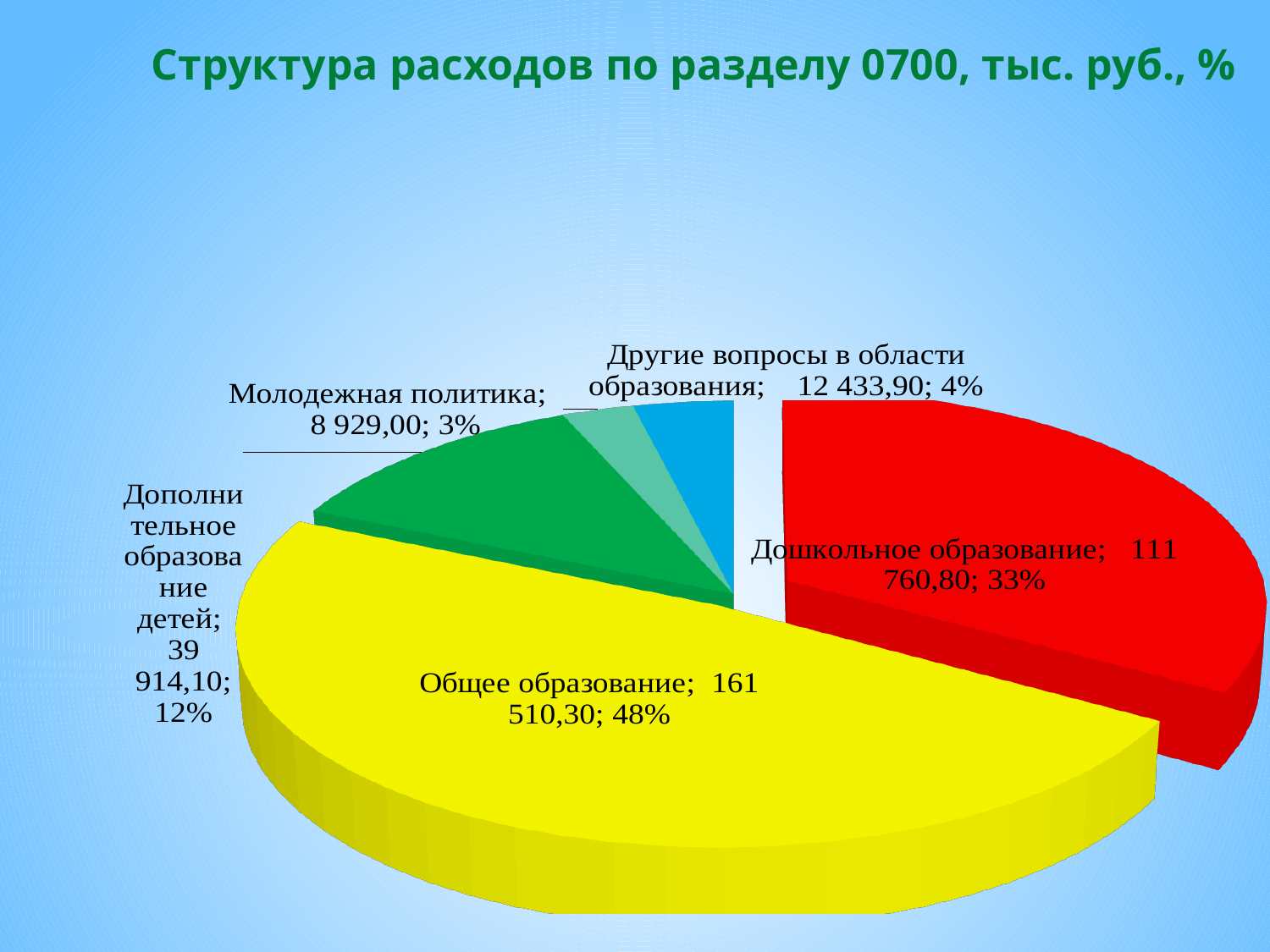
Which is larger, Дошкольное образование or Дополнительное образование детей? Дошкольное образование What is the title of the chart? Структура расходов по разделу 0700, тыс. руб., % What share of the pie does Общее образование represent? 48% What is the value for Общее образование? 161 510,30 What is the value for Дошкольное образование? 111 760,80 What is the value for Другие вопросы в области образования? 12 433,90 Which category has the largest slice? Общее образование What kind of chart is shown on the slide? pie chart How many slices does the pie chart have? 5 What share of the pie does Дополнительное образование детей represent? 12% What is the value for Молодежная политика? 8 929,00 Which category has the smallest slice? Молодежная политика